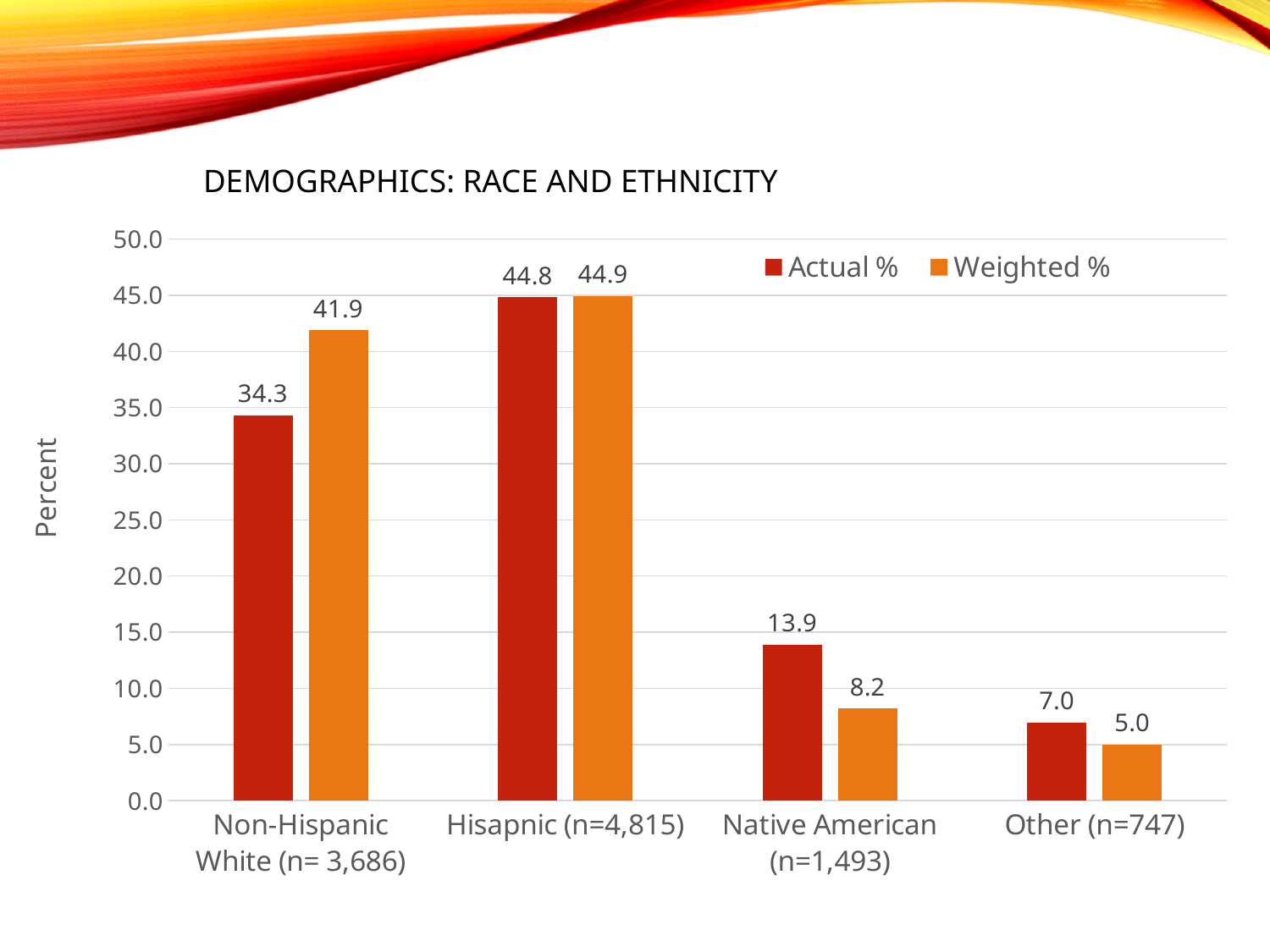
How many series does the legend list? 2 How many categories are shown on the x axis? 4 For Native American, which is larger: the Actual % or the Weighted % value? Actual % What is the Weighted % value for Native American? 8.2 What is the difference between the Actual % and Weighted % values for Native American? 5.7 Which category has the highest Actual % value? Hisapnic (n=4,815) What is the Actual % value for Non-Hispanic White? 34.3 Which category has the lowest Weighted % value? Other (n=747) What is the title of the chart? DEMOGRAPHICS: RACE AND ETHNICITY What is the difference between the Weighted % and Actual % values for Non-Hispanic White? 7.6 What kind of chart is shown on the slide? Bar chart What is the Weighted % value for Other? 5.0